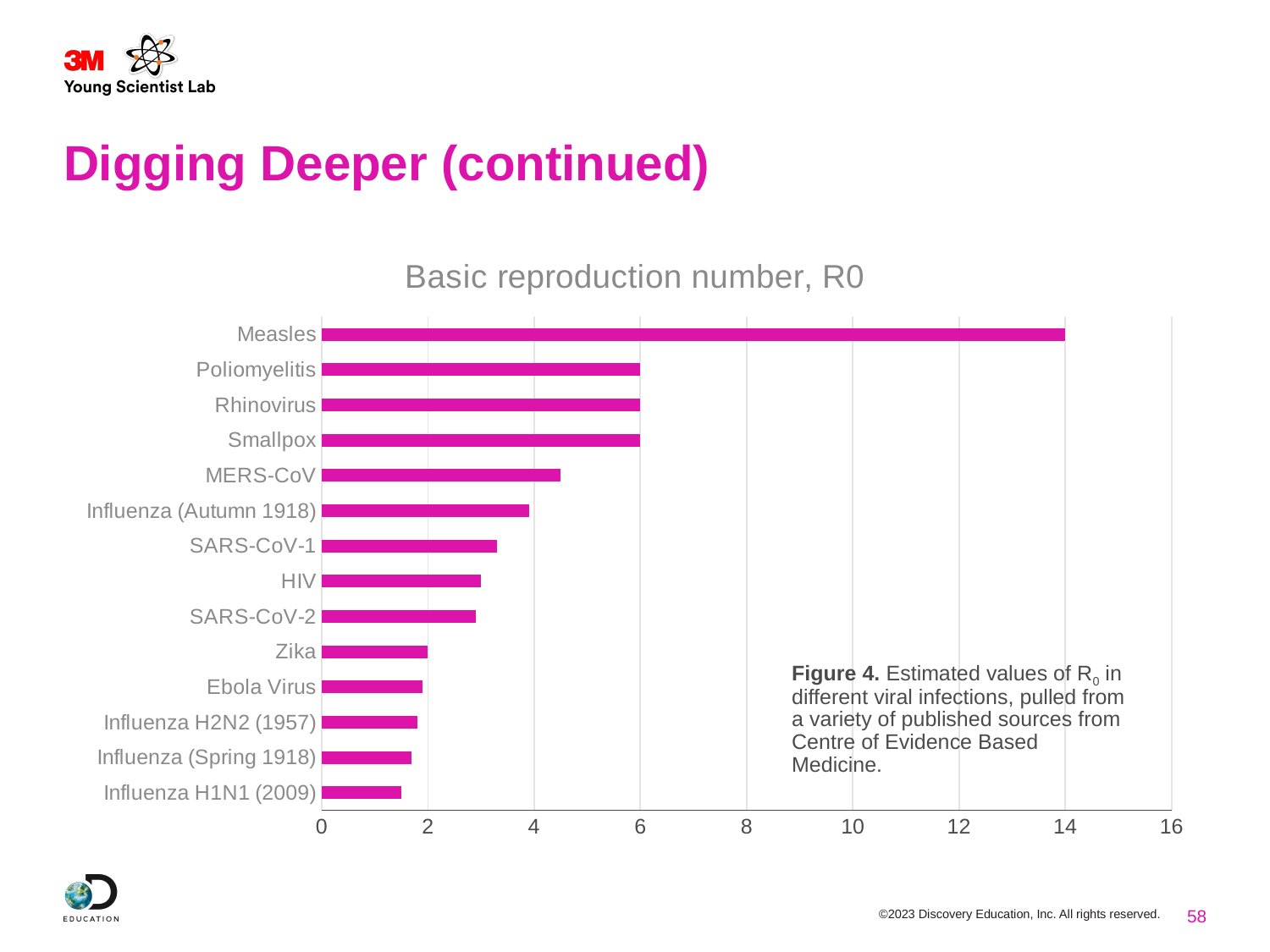
Which viral infection has the highest basic reproduction number in the chart? Measles What type of chart is shown on the slide? bar chart What is the basic reproduction number shown for Smallpox? 6 What is the difference between the values for Measles and Poliomyelitis? 8 Is the value for MERS-CoV greater or less than 4? greater Do the bar values increase or decrease going from the top of the chart (Measles) to the bottom (Influenza H1N1 (2009))? decrease What is the basic reproduction number shown for Measles? 14 Is the value for Influenza H1N1 (2009) greater or less than 2? less Which has a larger basic reproduction number, MERS-CoV or HIV? MERS-CoV How many viral infections are listed in the chart? 14 What is the basic reproduction number shown for Zika? 2 What is the title of the chart? Basic reproduction number, R0